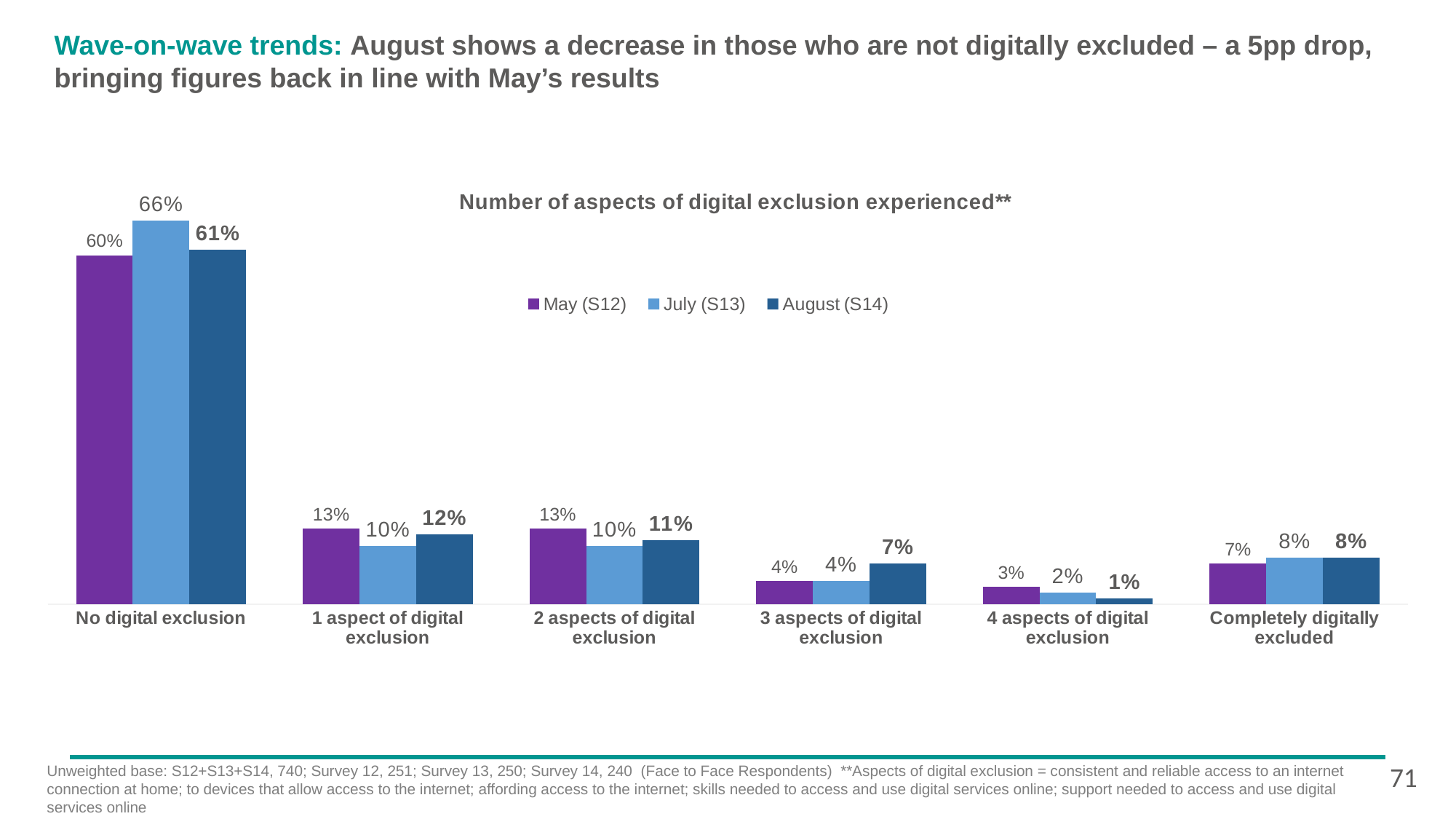
What is the August (S14) value for 'No digital exclusion'? 61% What is the July (S13) value for '3 aspects of digital exclusion'? 4% How many series does the legend list? 3 What is the difference between the July (S13) and August (S14) values for 'No digital exclusion'? 5% What kind of chart is shown on the slide? Bar chart What is the title of the chart? Number of aspects of digital exclusion experienced** Which is larger for '1 aspect of digital exclusion': the May (S12) value or the July (S13) value? May (S12) Which category has the highest value for July (S13)? No digital exclusion How many categories are shown on the x axis? 6 Which category has the lowest value for August (S14)? 4 aspects of digital exclusion Which series is shown in the darkest blue colour? August (S14) What is the May (S12) value for 'Completely digitally excluded'? 7%